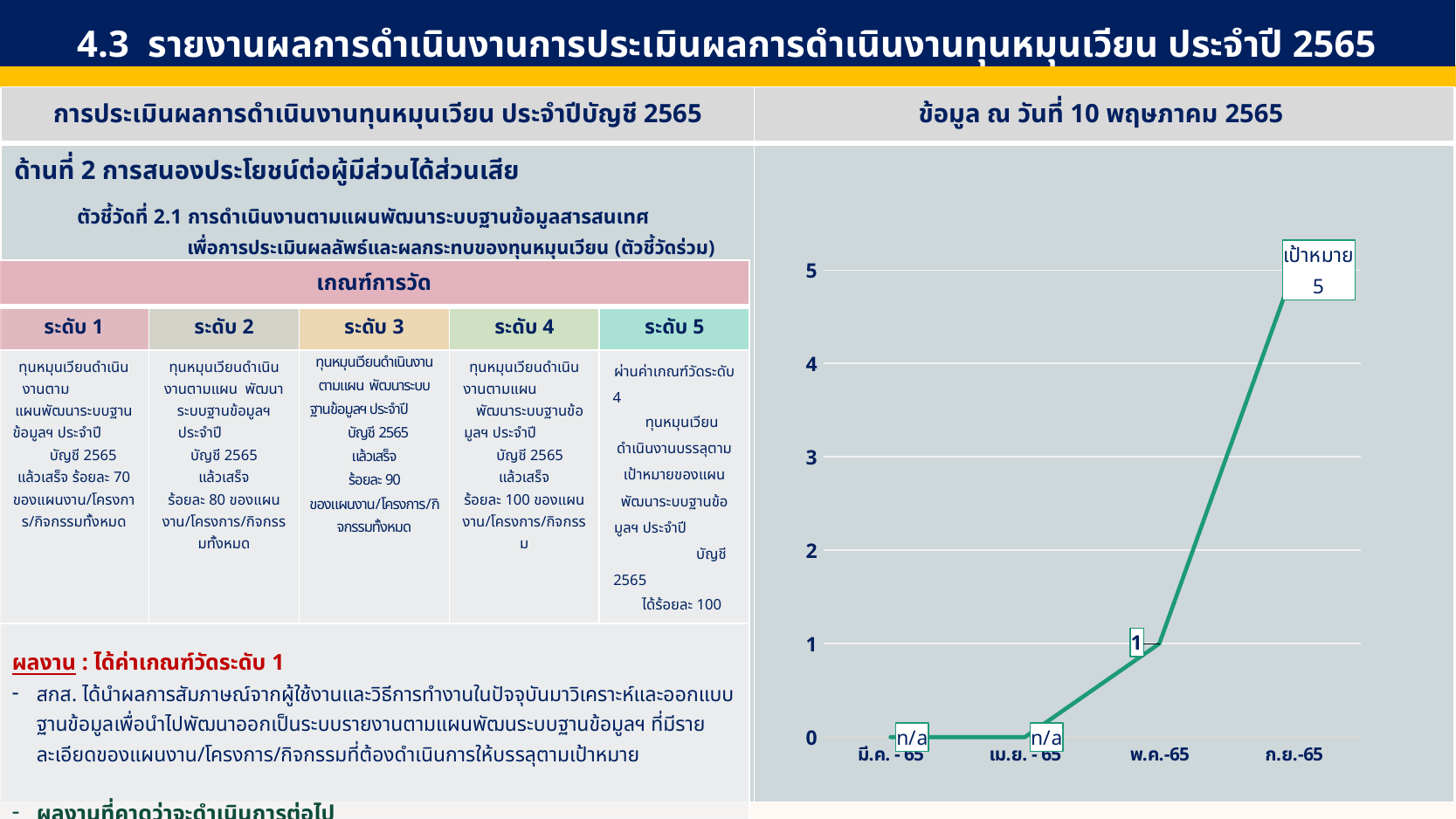
What is the data label for มี.ค. - 65 on the line chart? n/a Does the line on the chart rise or fall from พ.ค.-65 to ก.ย.-65? rise How many categories are shown on the x axis of the line chart? 4 Which is larger on the line chart, the value for พ.ค.-65 or the value for ก.ย.-65? ก.ย.-65 What is the difference between the value for ก.ย.-65 and the value for พ.ค.-65 on the line chart? 4 Which category has the highest value on the line chart? ก.ย.-65 What is the data label for เม.ย. - 65 on the line chart? n/a What word appears in the label box above the ก.ย.-65 point on the line chart? เป้าหมาย What type of chart is shown on the right side of the slide? line chart What is the data label for พ.ค.-65 on the line chart? 1 What value is shown in the label for ก.ย.-65 on the line chart? 5 What is the maximum value shown on the y axis of the line chart? 5